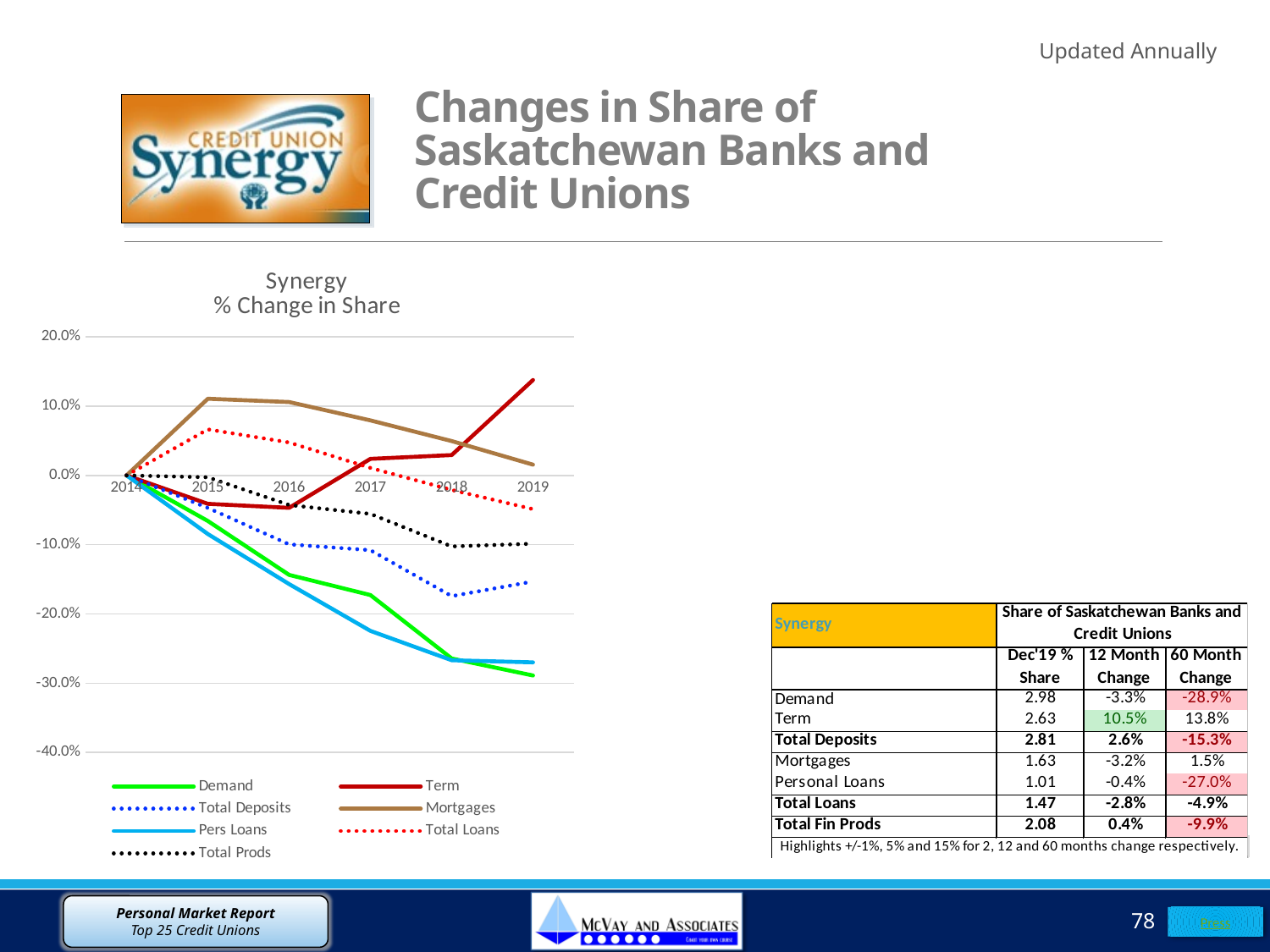
How many series does the chart legend list? 7 Is the value for Term in 2019 greater or less than 10.0%? greater In 2016, which is larger: Mortgages or Term? Mortgages Is the value for Pers Loans in 2017 greater or less than -20.0%? less What is the title of the chart? Synergy % Change in Share Which series has the highest value in 2019? Term Which series has the lowest value in 2017? Pers Loans Does the Mortgages series rise or fall from 2015 to 2019? fall How many years are shown along the x axis of the chart? 6 Is the value for Demand in 2019 greater or less than -20.0%? less What kind of chart is shown on the slide? line chart Which series has the highest value in 2015? Mortgages